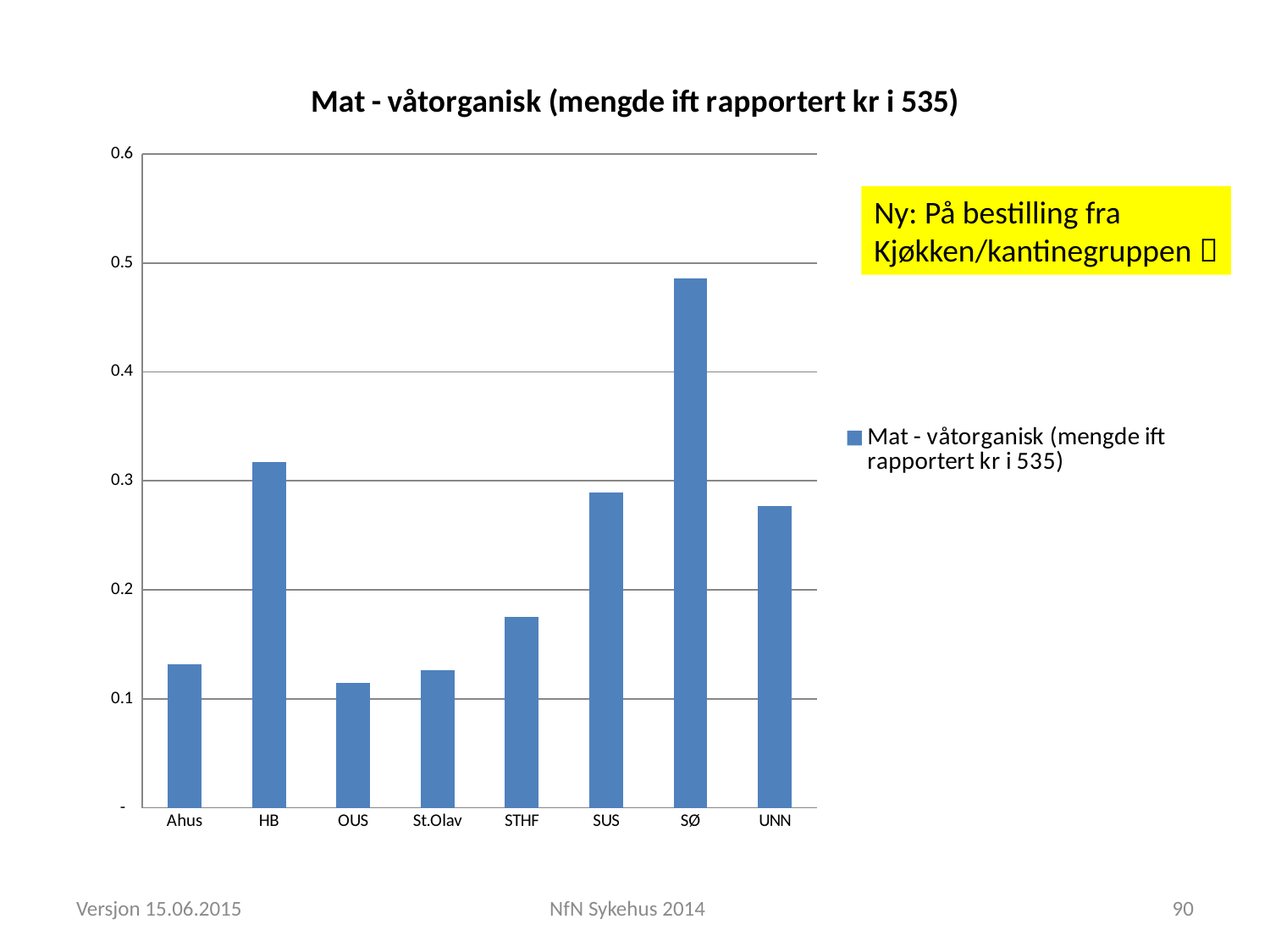
Which has a larger value, HB or UNN? HB Is the value for HB greater or less than 0.3? greater Which category has the highest value in the chart? SØ What is the title of the chart? Mat - våtorganisk (mengde ift rapportert kr i 535) What type of chart is shown on the slide? Bar chart Which has a larger value, STHF or Ahus? STHF Is the value for SØ greater or less than 0.4? greater Is the value for STHF greater or less than 0.2? less How many series does the chart's legend list? 1 How many categories (hospitals) are shown on the x axis of the chart? 8